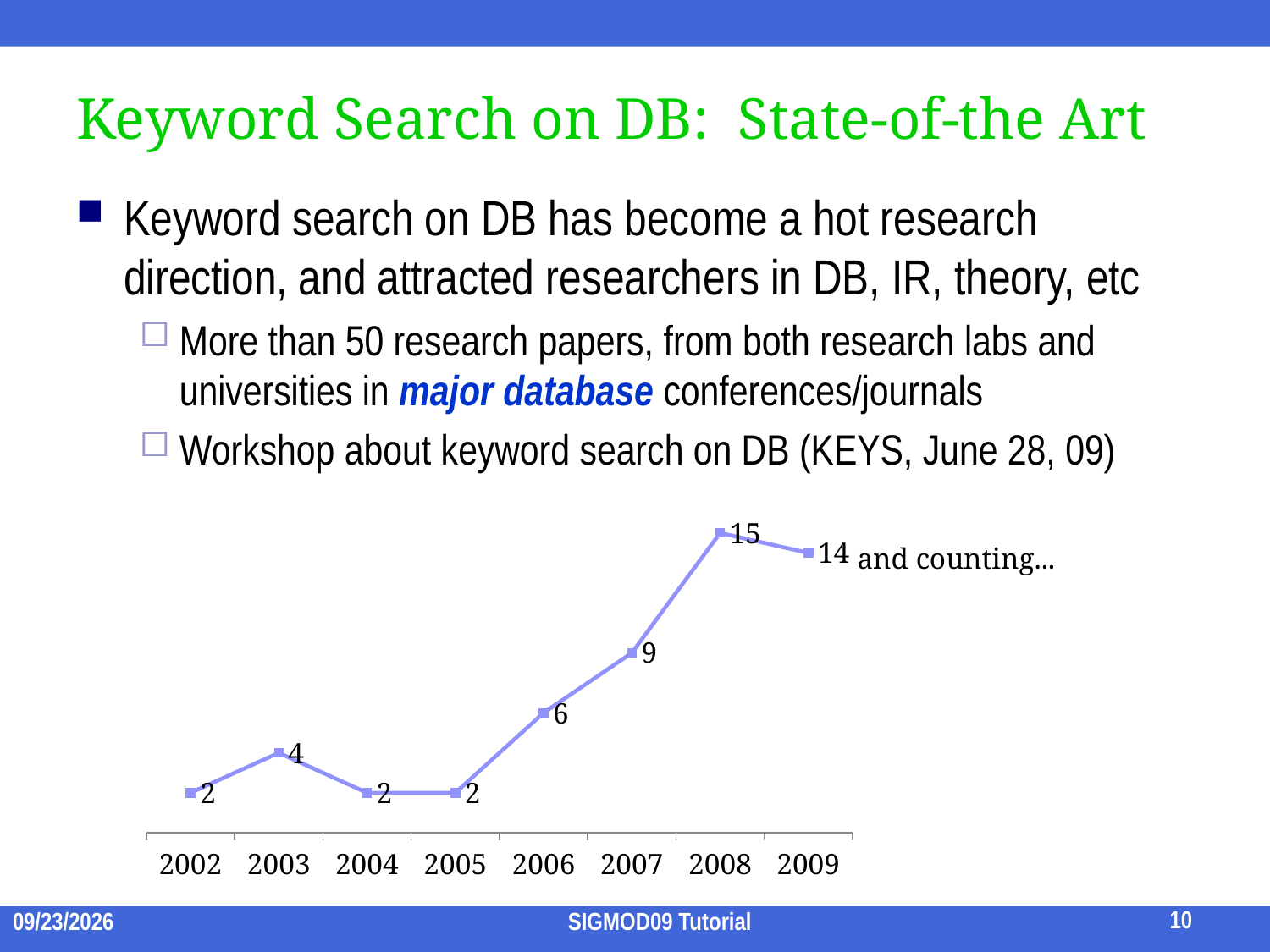
Do the values rise or fall from 2005 to 2008? rise What is the value for 2008? 15 What is the value for 2009? 14 What is the value for 2006? 6 What text is written next to the 2009 data point? 14 and counting... What kind of chart is shown on the slide? line chart What is the difference between the values for 2009 and 2002? 12 What is the difference between the values for 2008 and 2007? 6 Which is larger, the value for 2007 or the value for 2006? 2007 Which year has the highest value? 2008 What is the value for 2003? 4 How many years are plotted on the x axis? 8